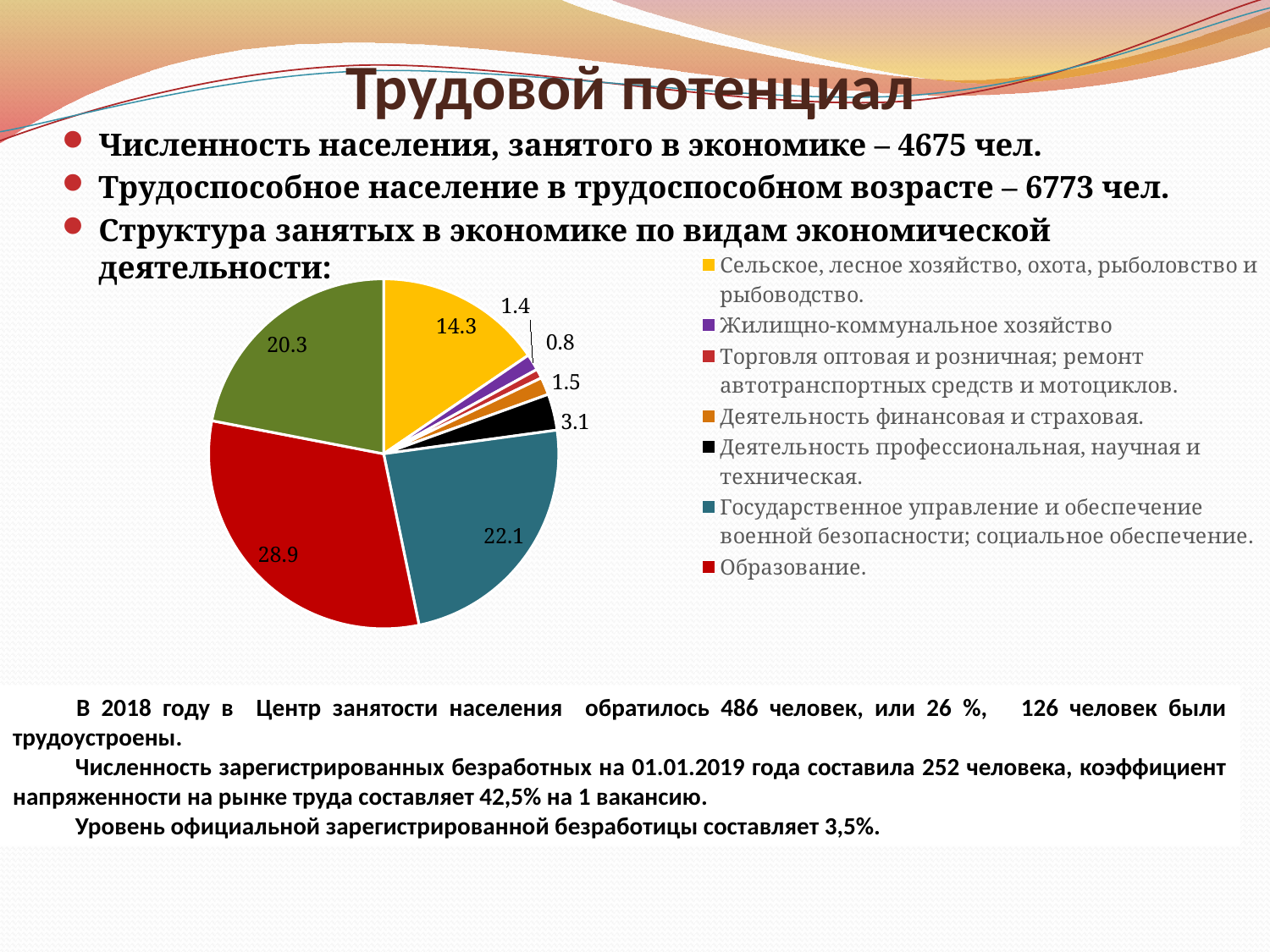
What value is shown for the slice 'Образование'? 28.9 What value is shown for the slice 'Сельское, лесное хозяйство, охота, рыболовство и рыбоводство'? 14.3 How many slices does the pie chart have? 8 What is the difference between the values for 'Образование' and 'Государственное управление и обеспечение военной безопасности; социальное обеспечение'? 6.8 What kind of chart is shown on the slide? pie chart How many entries does the legend of the pie chart list? 7 Which legend category has the largest slice in the pie chart? Образование Which legend category has the smallest slice in the pie chart? Торговля оптовая и розничная; ремонт автотранспортных средств и мотоциклов What value is shown for the slice 'Государственное управление и обеспечение военной безопасности; социальное обеспечение'? 22.1 What value is shown for the slice 'Деятельность профессиональная, научная и техническая'? 3.1 What value is shown for the slice 'Жилищно-коммунальное хозяйство'? 1.4 Which is larger: the slice for 'Сельское, лесное хозяйство, охота, рыболовство и рыбоводство' or the slice for 'Государственное управление и обеспечение военной безопасности; социальное обеспечение'? Государственное управление и обеспечение военной безопасности; социальное обеспечение